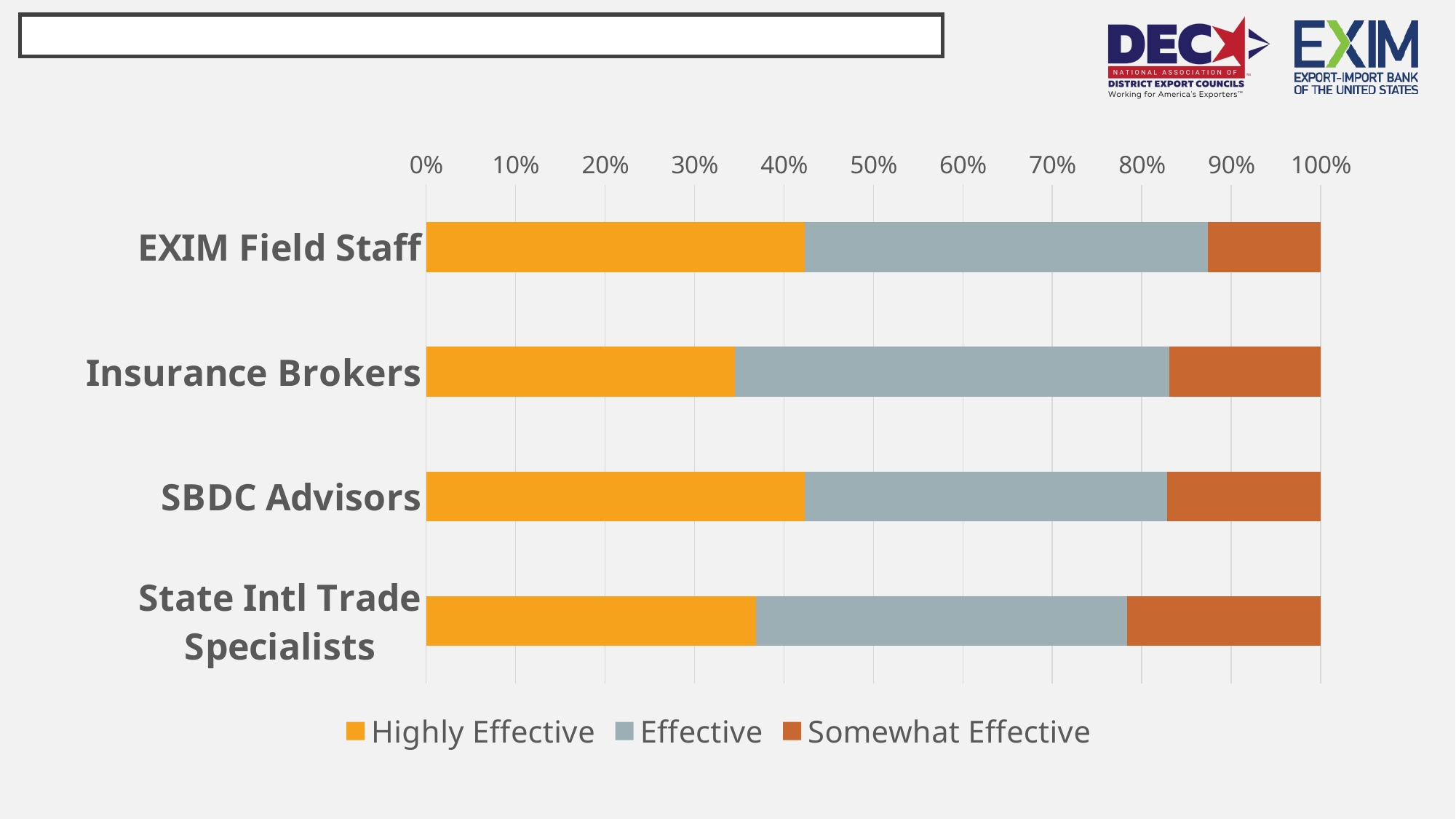
Which category has the smallest Highly Effective share? Insurance Brokers Is the Highly Effective value for SBDC Advisors greater or less than 30%? greater Is the Highly Effective value for State Intl Trade Specialists greater or less than 40%? less What kind of chart is shown on the slide? Stacked bar chart Is the Highly Effective value for Insurance Brokers greater or less than 40%? less How many categories (groups) are plotted on the chart? 4 Which category has the smallest Somewhat Effective share? EXIM Field Staff How many series does the legend list? 3 Which category has the largest Somewhat Effective share? State Intl Trade Specialists Which has the larger Highly Effective share: Insurance Brokers or State Intl Trade Specialists? State Intl Trade Specialists What colour represents the Highly Effective series in the legend? Orange